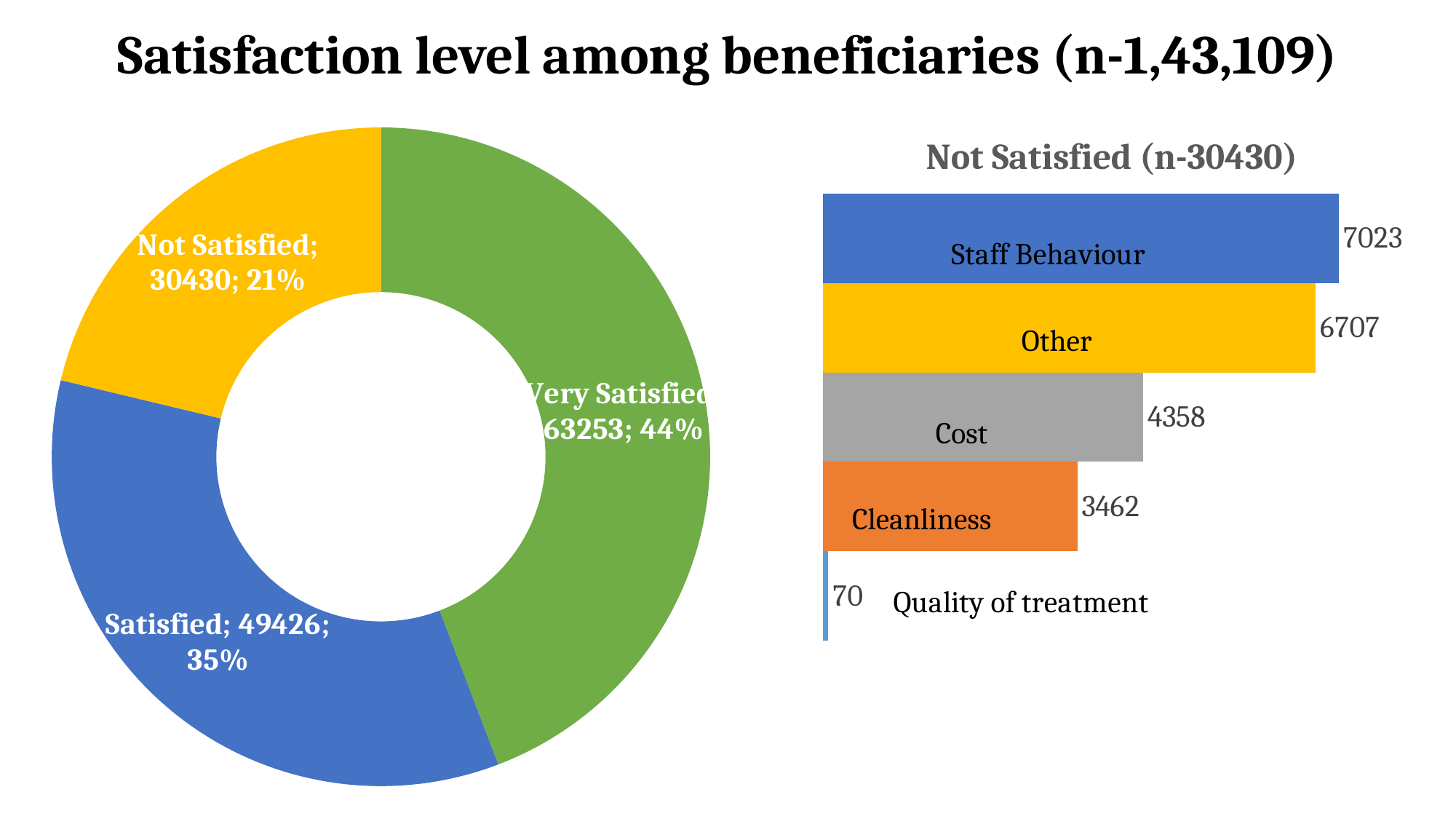
In the 'Not Satisfied (n-30430)' chart, what is the value for Quality of treatment? 70 In the doughnut chart on the left, what share of beneficiaries are Very Satisfied? 44% What kind of chart is the 'Not Satisfied (n-30430)' chart on the right? Bar chart In the 'Not Satisfied (n-30430)' chart, which category has the lowest value? Quality of treatment In the doughnut chart on the left, which category has the largest share? Very Satisfied In the 'Not Satisfied (n-30430)' chart, which is larger, Cost or Cleanliness? Cost In the 'Not Satisfied (n-30430)' chart, what is the difference between Staff Behaviour and Other? 316 In the doughnut chart on the left, what share of beneficiaries are Not Satisfied? 21% In the doughnut chart on the left, what is the value for Satisfied? 49426 In the 'Not Satisfied (n-30430)' chart, what is the value for Cost? 4358 In the 'Not Satisfied (n-30430)' chart, which category has the highest value? Staff Behaviour In the doughnut chart on the left, how many categories are shown? 3